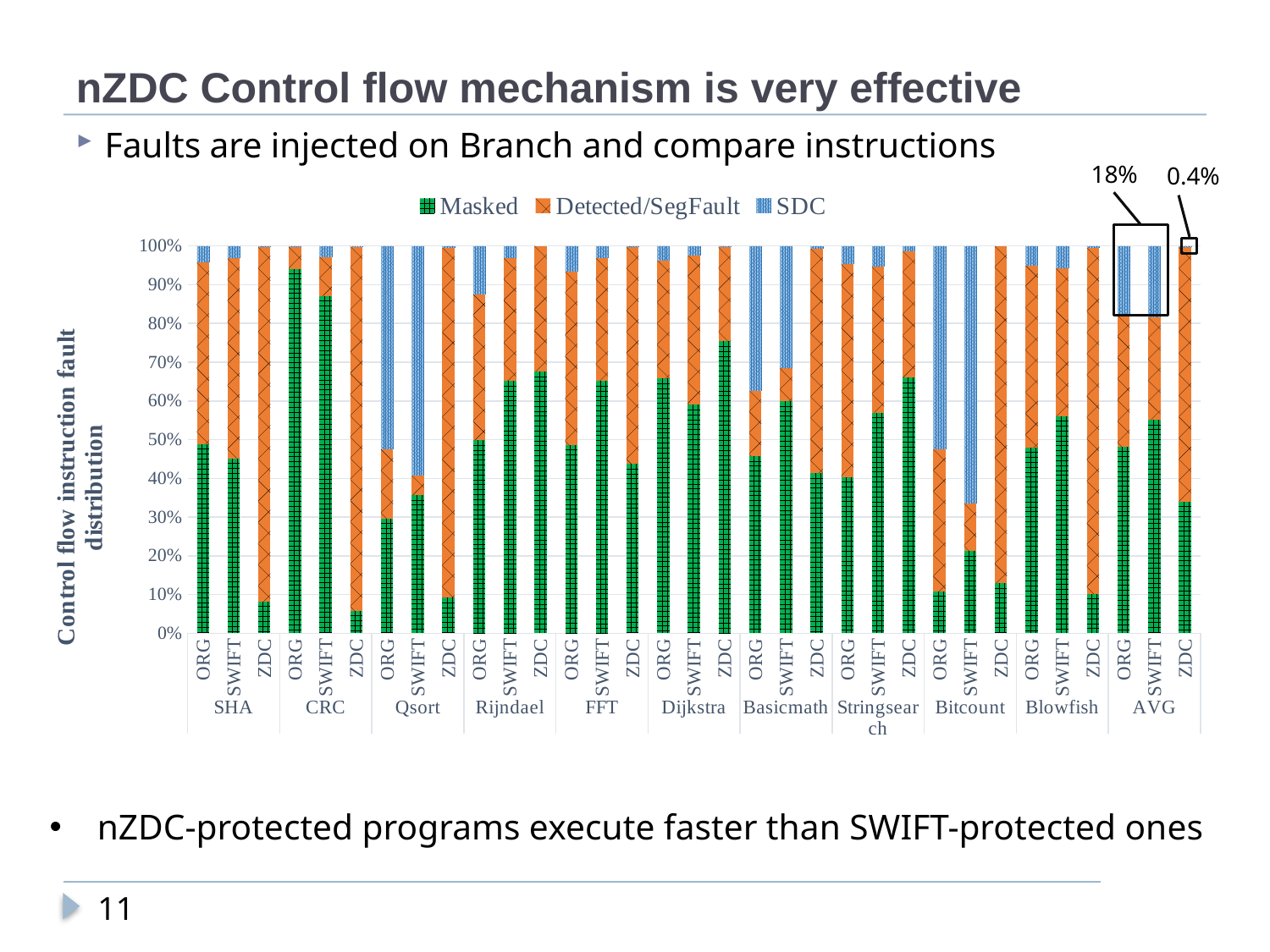
Is the Masked share for the CRC ORG bar greater or less than 90%? greater Is the Masked share for the SHA ZDC bar greater or less than 10%? less What SDC value is annotated for the AVG ZDC bar? 0.4% Is the Masked share for the Dijkstra ZDC bar greater or less than 70%? greater How many benchmark groups (including AVG) are shown along the x axis? 11 What are the three series named in the chart legend? Masked, Detected/SegFault, SDC How many series does the chart legend list? 3 What value is annotated above the boxed SDC region of the AVG group? 18% What is the title of the vertical axis? Control flow instruction fault distribution What kind of chart is shown on the slide? stacked bar chart Which bar has the larger Masked share, CRC ORG or SHA ORG? CRC ORG How many bars are plotted in the chart in total? 33